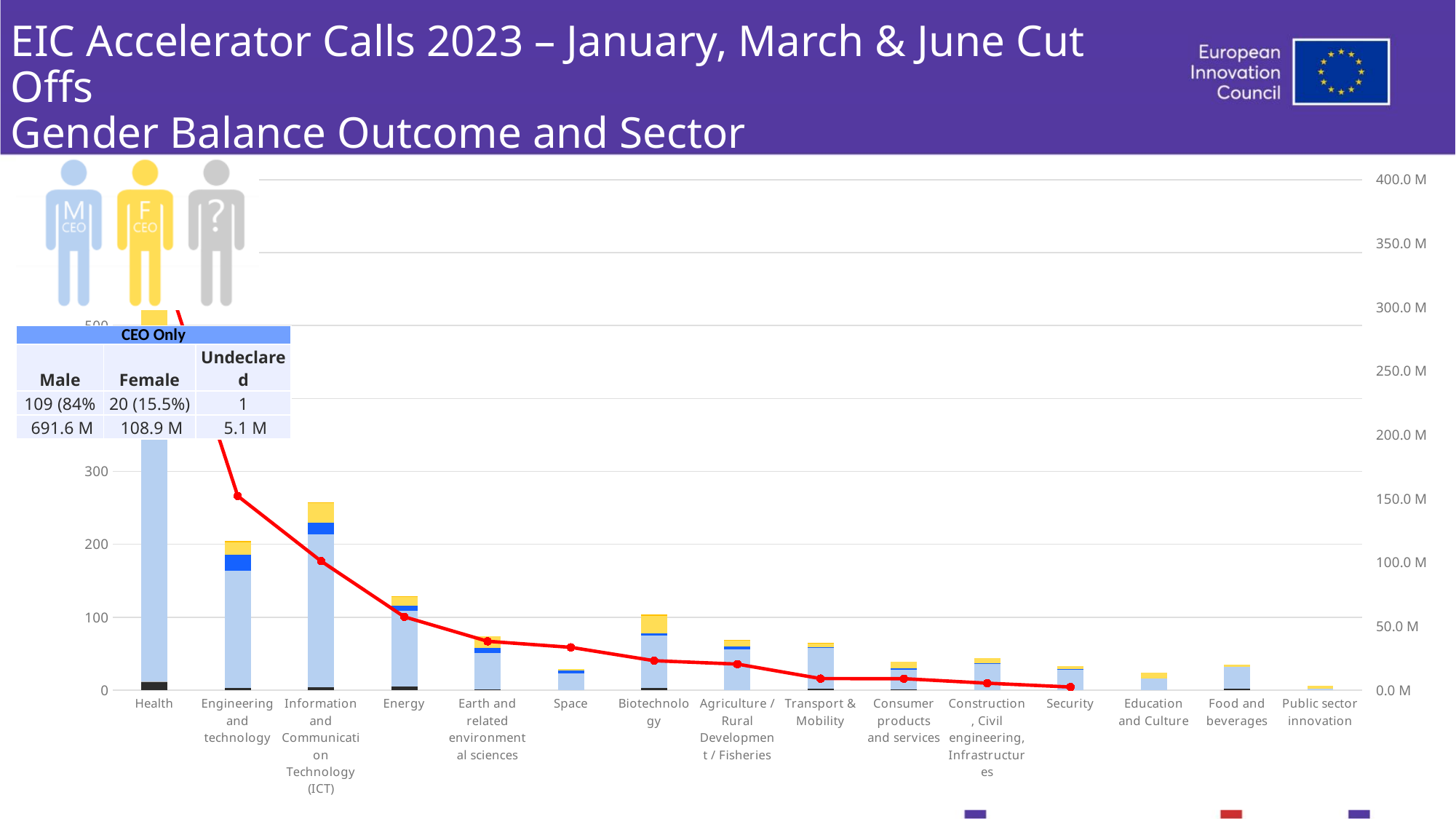
Which sector has the shortest bar in the chart? Public sector innovation Which bar is taller, Biotechnology or Space? Biotechnology Is the bar for Health greater or less than 300 on the left axis? greater Does the red line rise or fall from left to right across the sectors? fall How many sector categories are shown on the x axis of the chart? 15 Is the bar for Energy greater or less than 100 on the left axis? greater Which sector has the tallest bar in the chart? Health In the CEO Only table on the slide, what funding amount is shown for Female? 108.9 M Is the bar for Space greater or less than 50 on the left axis? less Which bar is taller, Engineering and technology or Information and Communication Technology (ICT)? Information and Communication Technology (ICT) What kind of chart is shown on the slide? bar chart with a line